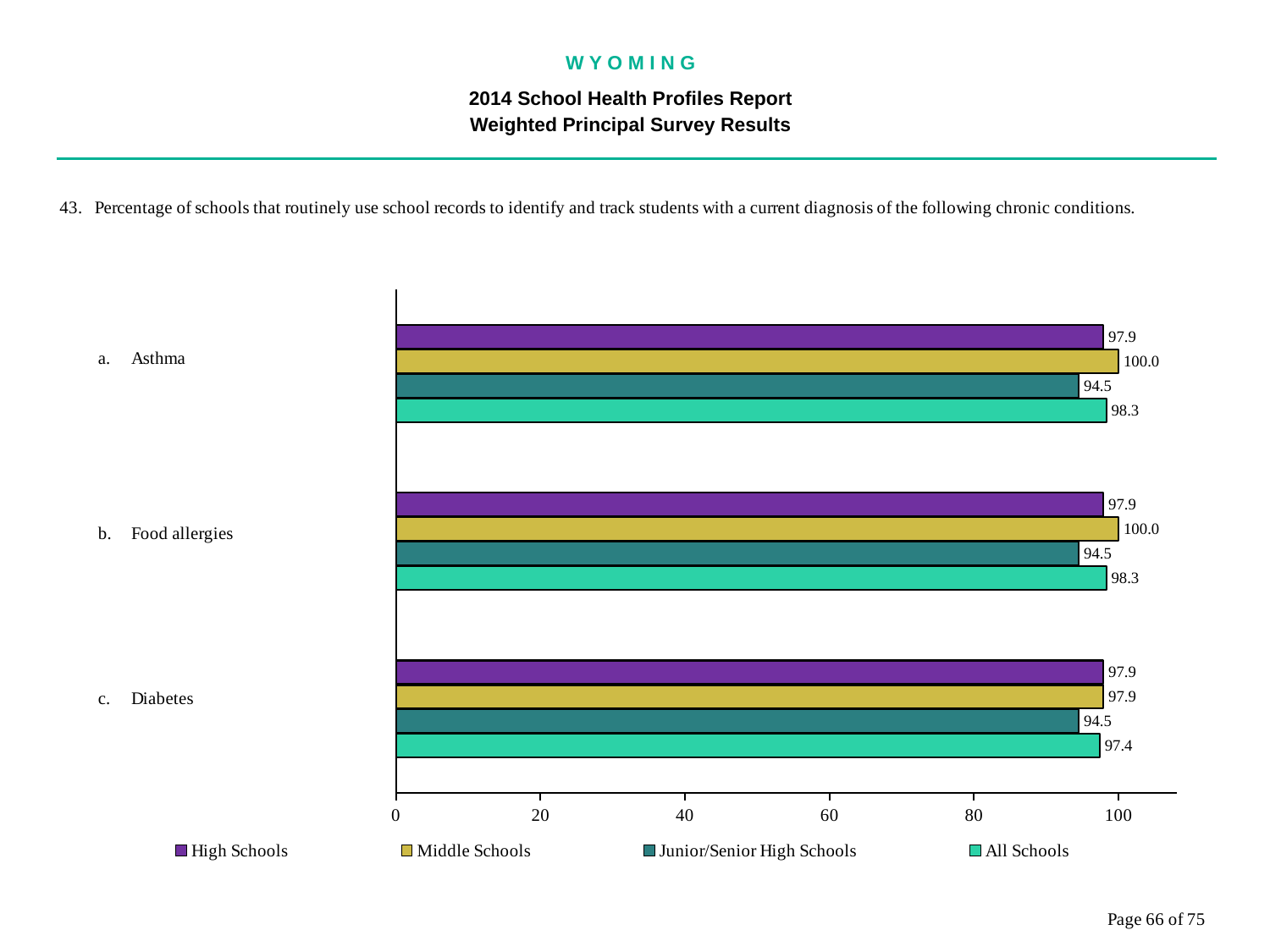
Which is larger for Diabetes: the All Schools value or the Junior/Senior High Schools value? All Schools What is the value for Middle Schools for Asthma? 100.0 How many chronic conditions (categories) are shown on the chart? 3 What is the value for All Schools for Food allergies? 98.3 Which series has the highest value for Food allergies? Middle Schools What kind of chart is shown on the slide? Bar chart Which legend entry is shown in purple? High Schools What is the difference between the Middle Schools and Junior/Senior High Schools values for Asthma? 5.5 How many series does the legend list? 4 Which series has the lowest value for Asthma? Junior/Senior High Schools What is the value for High Schools for Diabetes? 97.9 What is the value for Junior/Senior High Schools for Diabetes? 94.5